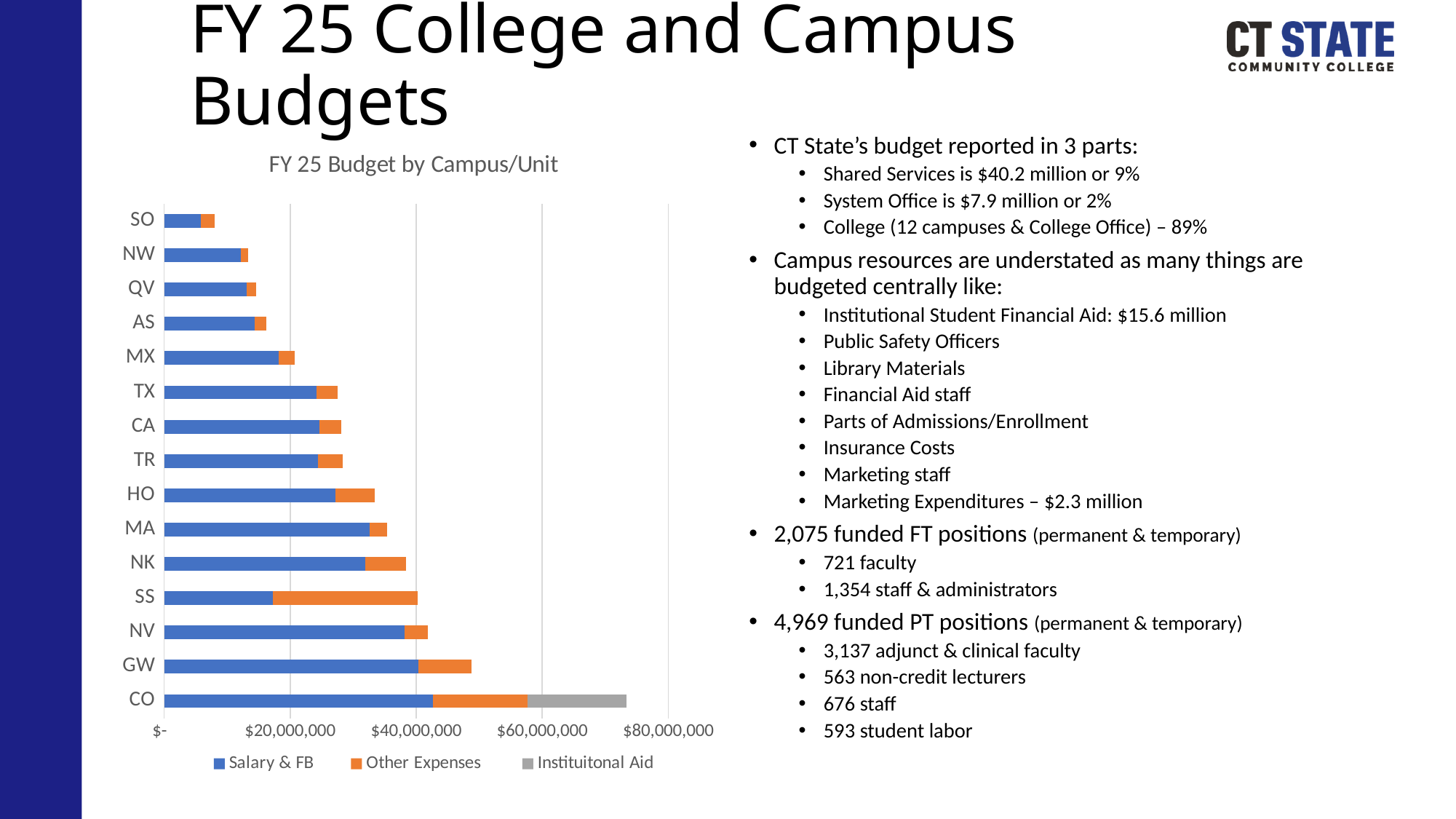
Is the total budget bar for HO greater or less than $40,000,000? less Is the total budget bar for GW greater or less than $40,000,000? greater Is the total budget bar for SO greater or less than $20,000,000? less Which campus/unit has the smallest total budget bar? SO Which has the larger total budget bar, GW or HO? GW What kind of chart is shown on the slide? bar chart Which campus/unit has the largest total budget bar? CO How many series does the chart legend list? 3 What is the title of the chart? FY 25 Budget by Campus/Unit How many campuses/units are plotted on the chart? 15 Which campus/unit is the only one showing an Instituitonal Aid segment? CO